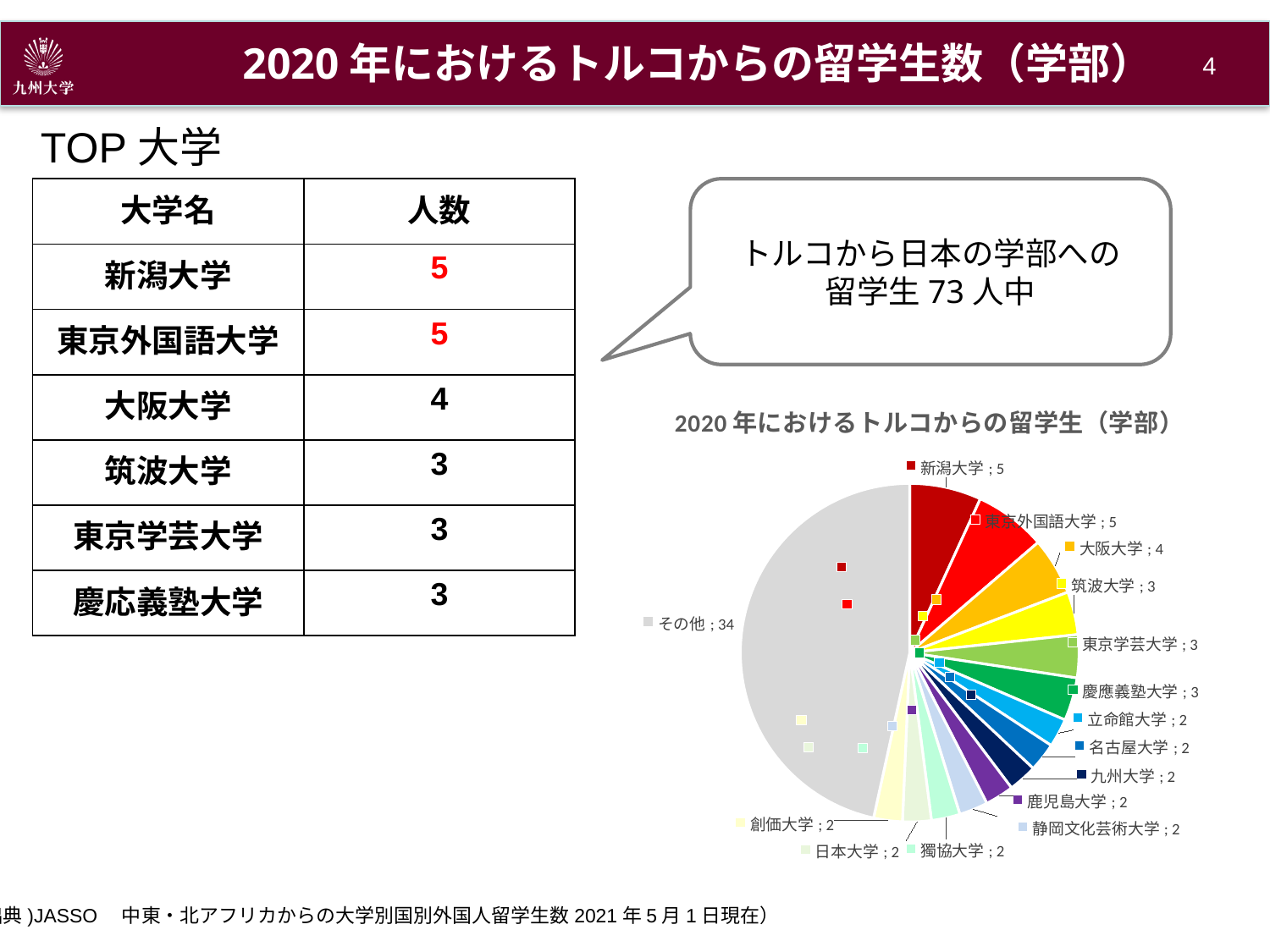
What kind of chart is shown on the slide? pie chart What is the difference between the values for その他 and 新潟大学? 29 What is the difference between the values for 大阪大学 and 九州大学? 2 What is the title of the chart? 2020年におけるトルコからの留学生（学部） Which has a larger value, 大阪大学 or 筑波大学? 大阪大学 What value does the chart show for その他? 34 What is the total of all the values shown in the pie chart? 73 What value does the chart show for 大阪大学? 4 What value does the chart show for 九州大学? 2 How many slices does the pie chart have? 15 Which slice of the pie chart is the largest? その他 How many students from Turkey does the chart show for 新潟大学? 5